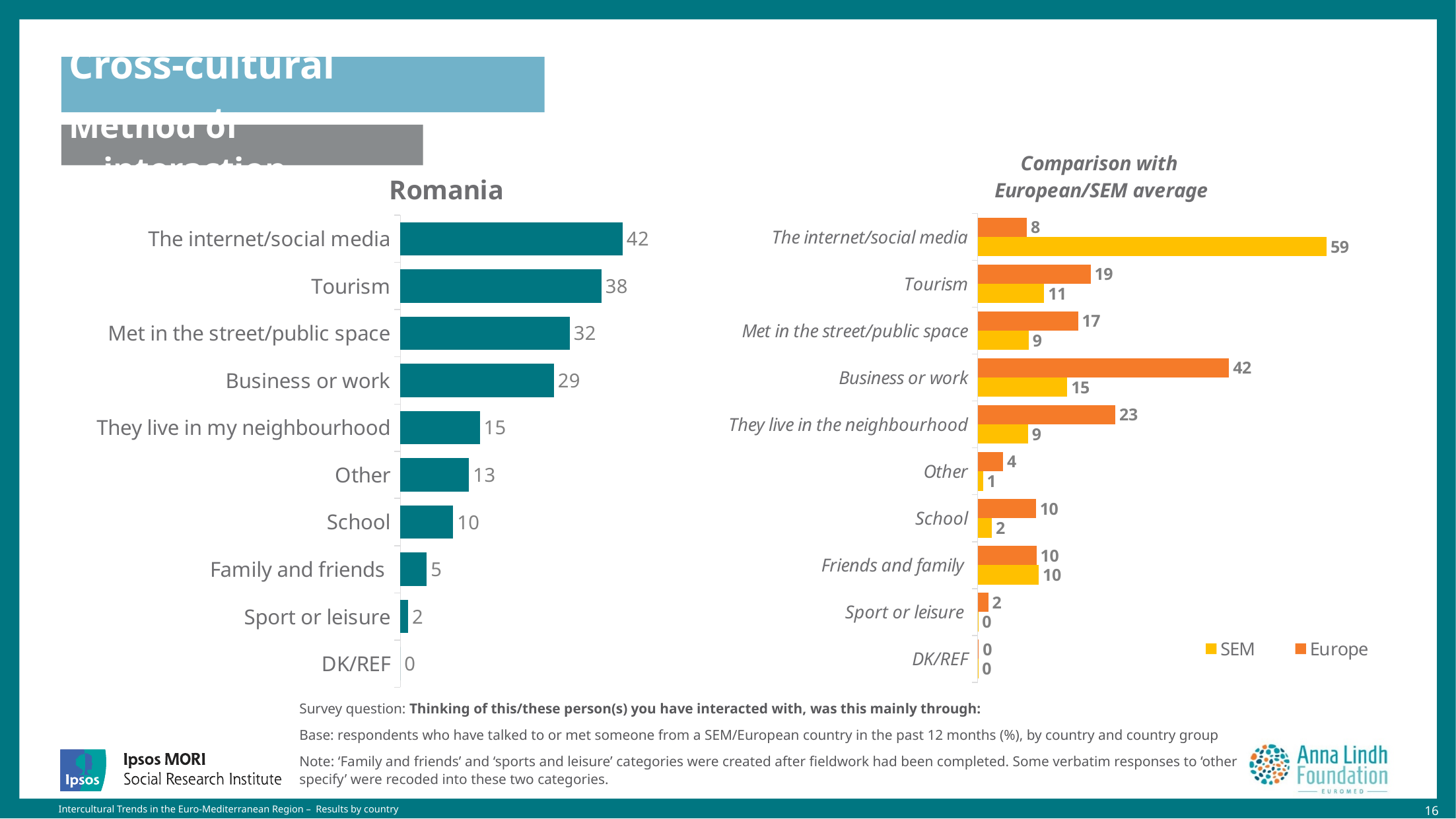
In the Romania chart, which category has the highest value? The internet/social media In the Comparison with European/SEM average chart, what is the Europe value for Business or work? 42 In the Comparison with European/SEM average chart, which is larger for Tourism, the SEM value or the Europe value? Europe In the Romania chart, how many categories are shown? 10 In the Comparison with European/SEM average chart, what is the difference between the Europe and SEM values for They live in the neighbourhood? 14 In the Romania chart, what is the value for Tourism? 38 In the Comparison with European/SEM average chart, how many series does the legend list? 2 What kind of chart is the Romania chart? Bar chart In the Comparison with European/SEM average chart, what is the SEM value for The internet/social media? 59 In the Romania chart, what is the difference between the values for The internet/social media and Business or work? 13 In the Comparison with European/SEM average chart, which colour represents the SEM series? Yellow In the Romania chart, what is the value for Family and friends? 5